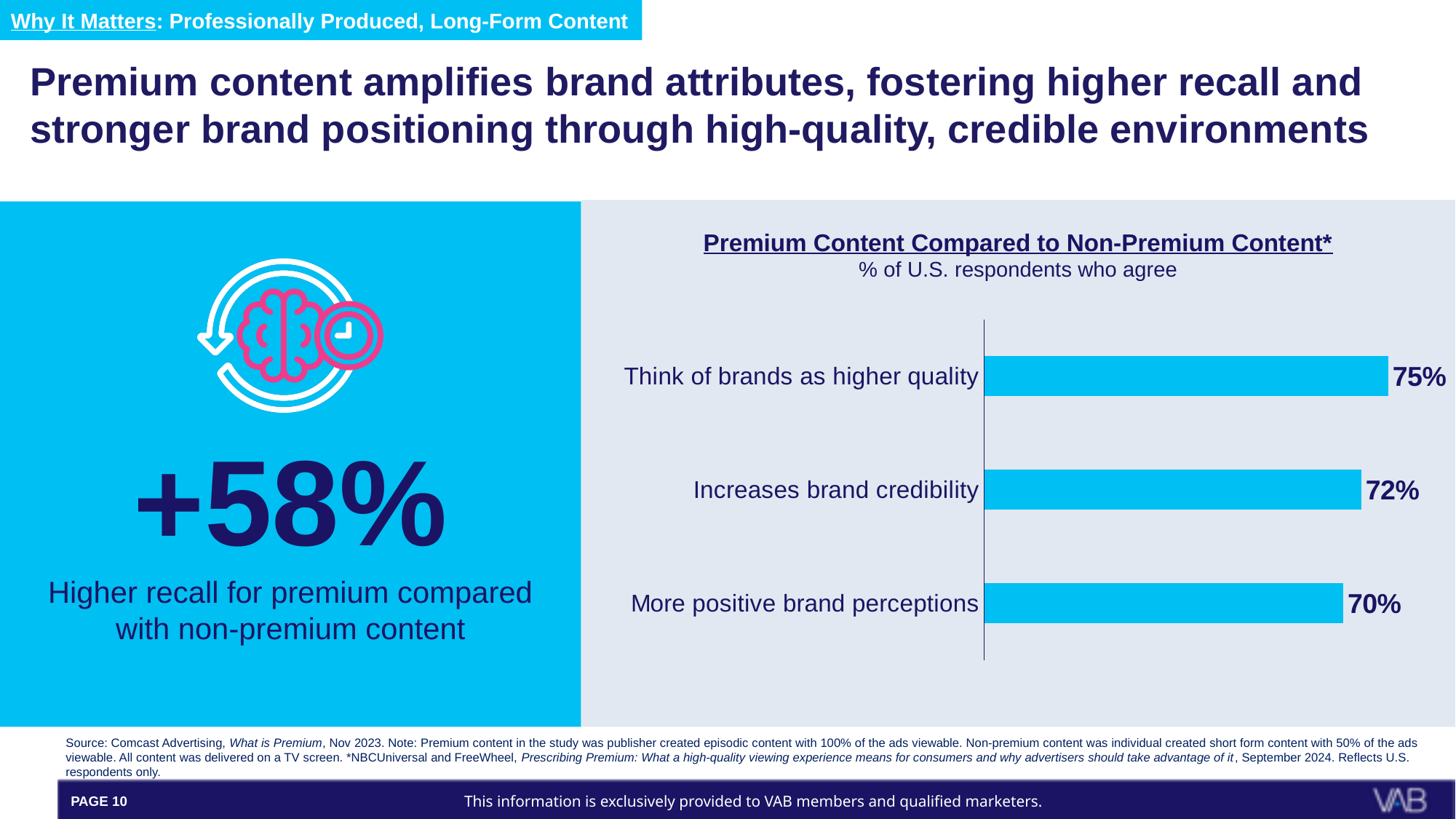
What is the value for 'More positive brand perceptions' in the chart? 70% What is the difference between 'Increases brand credibility' and 'More positive brand perceptions'? 2 percentage points What does the chart's subtitle say the values represent? % of U.S. respondents who agree What is the value for 'Increases brand credibility' in the chart? 72% Which category has the lowest percentage of respondents who agree? More positive brand perceptions What type of chart is shown on the slide? Bar chart Which category has the highest percentage of respondents who agree? Think of brands as higher quality What percentage of U.S. respondents agree that premium content makes them think of brands as higher quality? 75% Which is larger: the value for 'Think of brands as higher quality' or the value for 'Increases brand credibility'? Think of brands as higher quality What is the difference in percentage points between 'Think of brands as higher quality' and 'More positive brand perceptions'? 5 percentage points What is the title of the chart? Premium Content Compared to Non-Premium Content* How many categories are shown in the chart? 3